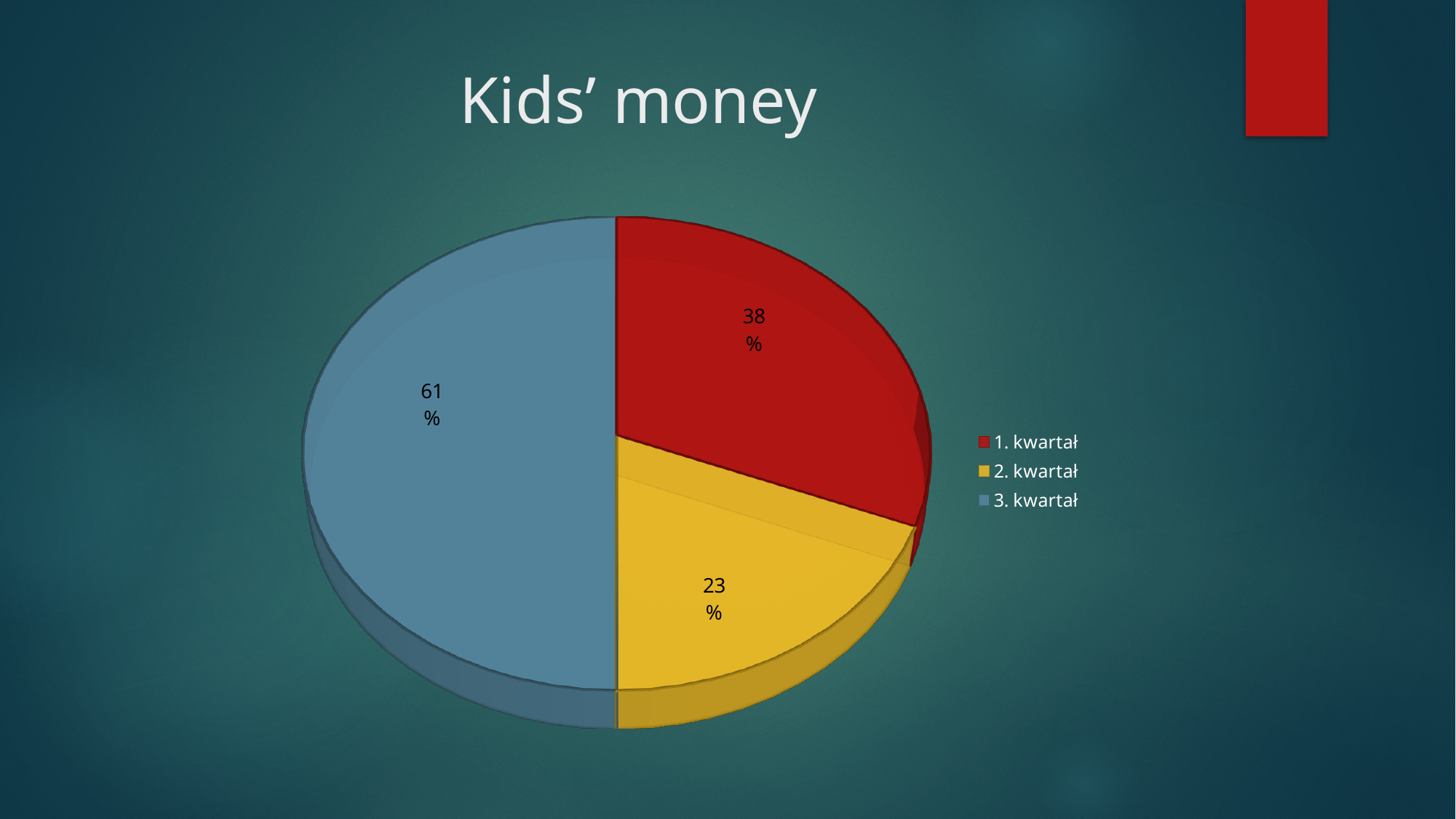
How many slices does the pie chart have? 3 What colour is the slice for 2. kwartał? yellow Which category has the largest slice of the pie? 3. kwartał What is the difference in percentage points between the 3. kwartał slice and the 1. kwartał slice? 23 What percentage is shown for 2. kwartał? 23% How many entries does the legend list? 3 What kind of chart is shown on the slide? pie chart What is the title of the chart? Kids' money What percentage is shown for 3. kwartał? 61% Which is larger, the slice for 1. kwartał or the slice for 2. kwartał? 1. kwartał Which category has the smallest slice of the pie? 2. kwartał What percentage is shown for 1. kwartał? 38%